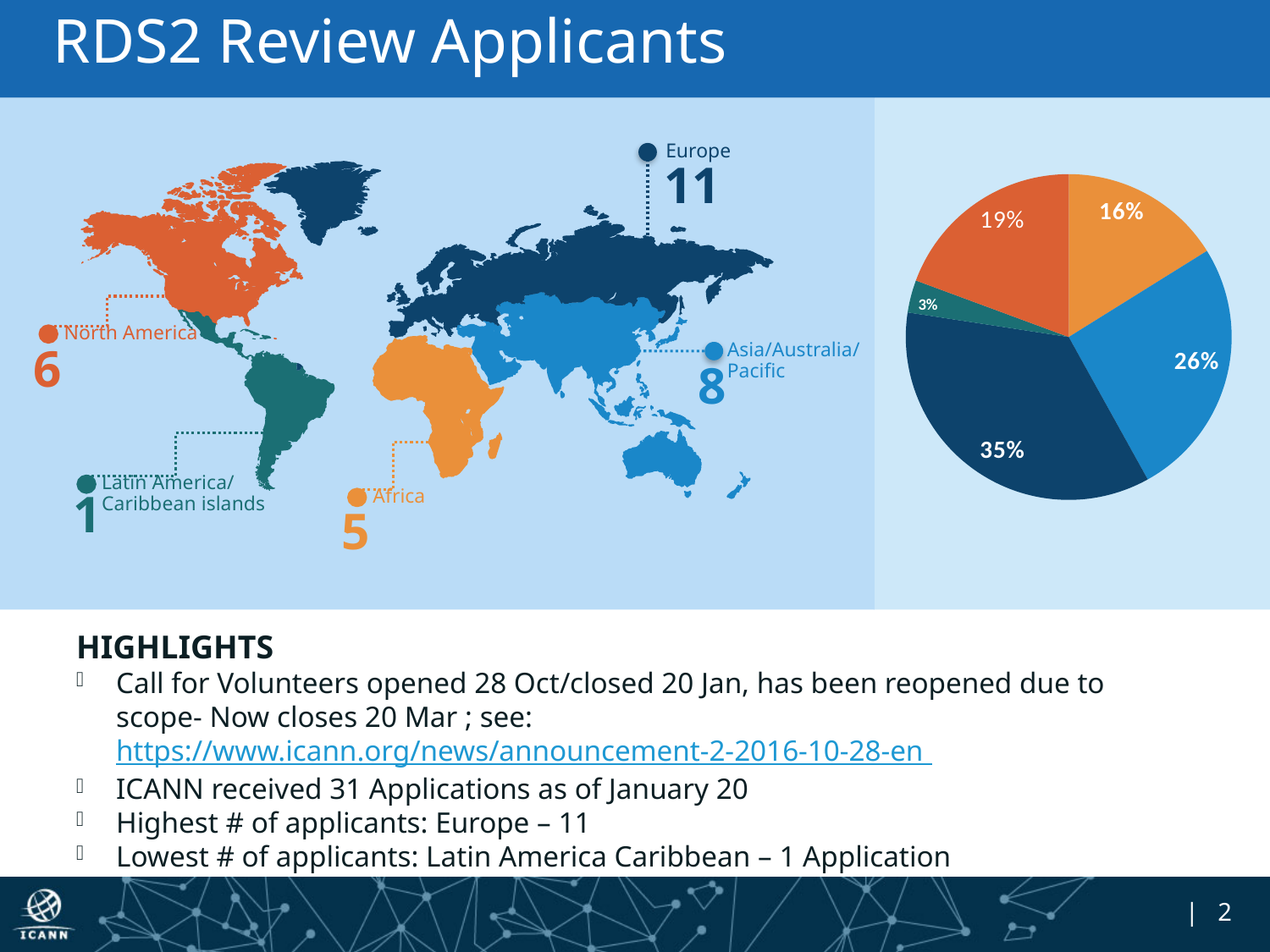
On the world map, which region has the lowest number of applicants? Latin America/Caribbean islands What is the largest percentage shown on the pie chart? 35% How many slices does the pie chart have? 5 On the world map, how many applicants are shown for Europe? 11 What is the difference between the 35% slice and the 26% slice of the pie chart? 9% Which is larger on the pie chart, the 19% slice or the 16% slice? 19% On the world map, how many applicants are shown for Asia/Australia/Pacific? 8 What percentage is shown on the light blue slice of the pie chart? 26% What percentage is shown on the teal (dark green) slice of the pie chart? 3% What percentage is shown on the dark blue slice of the pie chart? 35% What kind of chart is shown on the right side of the slide? pie chart What is the smallest percentage shown on the pie chart? 3%